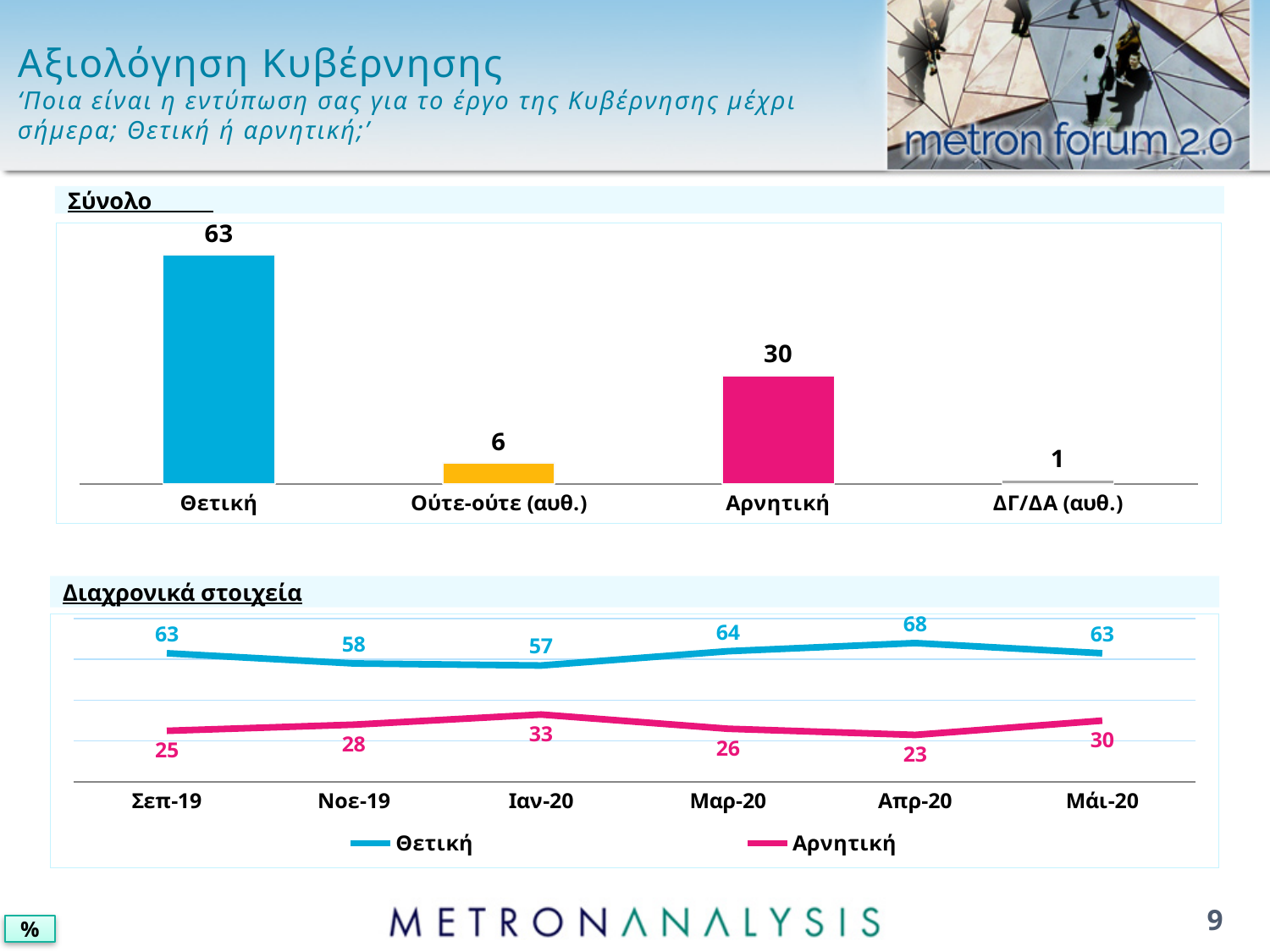
In the 'Σύνολο' bar chart, what is the difference between Θετική and Αρνητική? 33 In the 'Σύνολο' bar chart, how many categories are shown? 4 In the 'Σύνολο' bar chart, which category has the lowest value? ΔΓ/ΔΑ (αυθ.) In the 'Διαχρονικά στοιχεία' line chart, what is the value for Θετική in Απρ-20? 68 In the 'Σύνολο' bar chart, what is the value for Ούτε-ούτε (αυθ.)? 6 In the 'Διαχρονικά στοιχεία' line chart, how many series does the legend list? 2 In the 'Διαχρονικά στοιχεία' line chart, what is the difference between Θετική and Αρνητική in Σεπ-19? 38 In the 'Διαχρονικά στοιχεία' line chart, does Θετική rise or fall from Μαρ-20 to Απρ-20? Rise In the 'Διαχρονικά στοιχεία' line chart, what is the value for Αρνητική in Ιαν-20? 33 In the 'Σύνολο' bar chart, what is the value for Θετική? 63 In the 'Διαχρονικά στοιχεία' line chart, in which period is Αρνητική lowest? Απρ-20 What kind of chart is the 'Σύνολο' chart? Bar chart